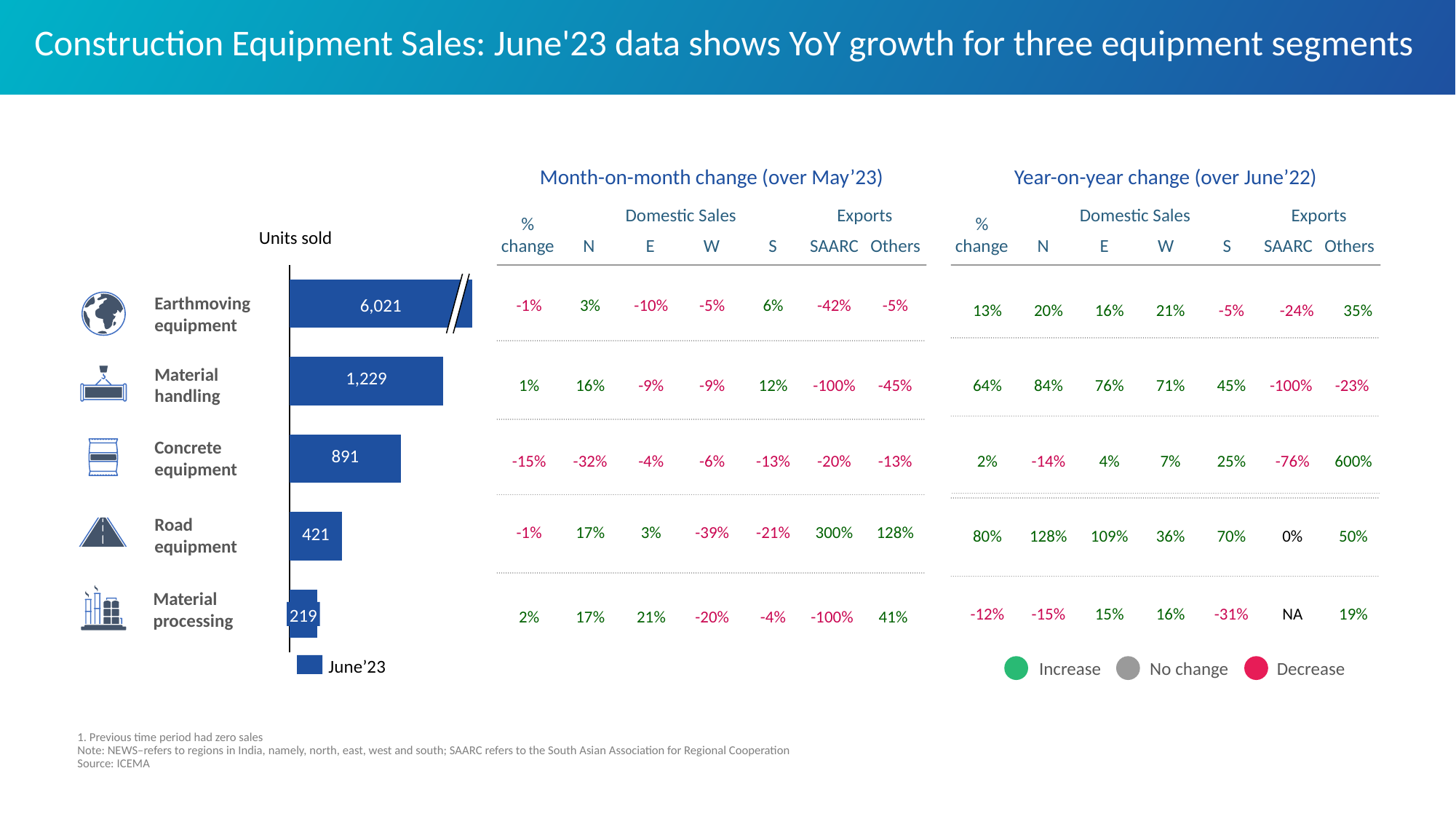
How many units of Road equipment were sold in June'23? 421 How many units of Material processing equipment were sold in June'23? 219 Which equipment segment had the lowest units sold in June'23? Material processing How many units of Earthmoving equipment were sold in June'23? 6,021 Which sold more units in June'23, Road equipment or Material processing? Road equipment What kind of chart shows the units sold by equipment segment? Bar chart What is the difference in units sold between Material handling and Concrete equipment? 338 Which equipment segment had the highest units sold in June'23? Earthmoving equipment How many equipment segments are shown in the units sold bar chart? 5 How many units of Concrete equipment were sold in June'23? 891 What series does the legend of the units sold bar chart list? June'23 How many units of Material handling equipment were sold in June'23? 1,229